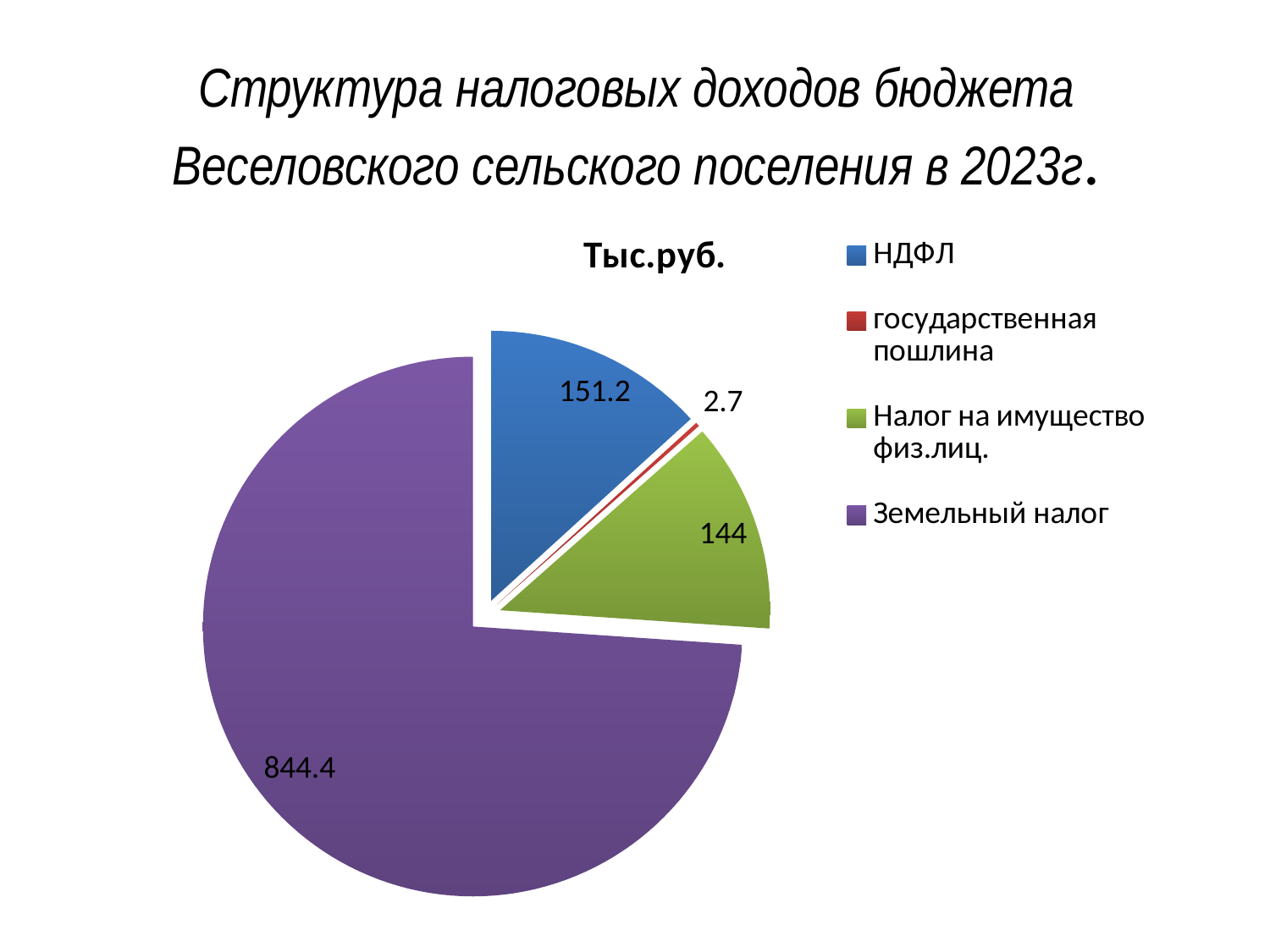
How many categories does the legend list? 4 What is the title shown above the pie chart? Тыс.руб. What is the difference between the values for НДФЛ and Налог на имущество физ.лиц.? 7.2 Which is larger, the value for НДФЛ or the value for Налог на имущество физ.лиц.? НДФЛ What is the value for НДФЛ? 151.2 What is the value for государственная пошлина? 2.7 Which category has the largest slice of the pie? Земельный налог What kind of chart is shown on the slide? pie chart What is the difference between the values for Земельный налог and НДФЛ? 693.2 What is the value for Налог на имущество физ.лиц.? 144 What is the value for Земельный налог? 844.4 Which category has the smallest slice of the pie? государственная пошлина